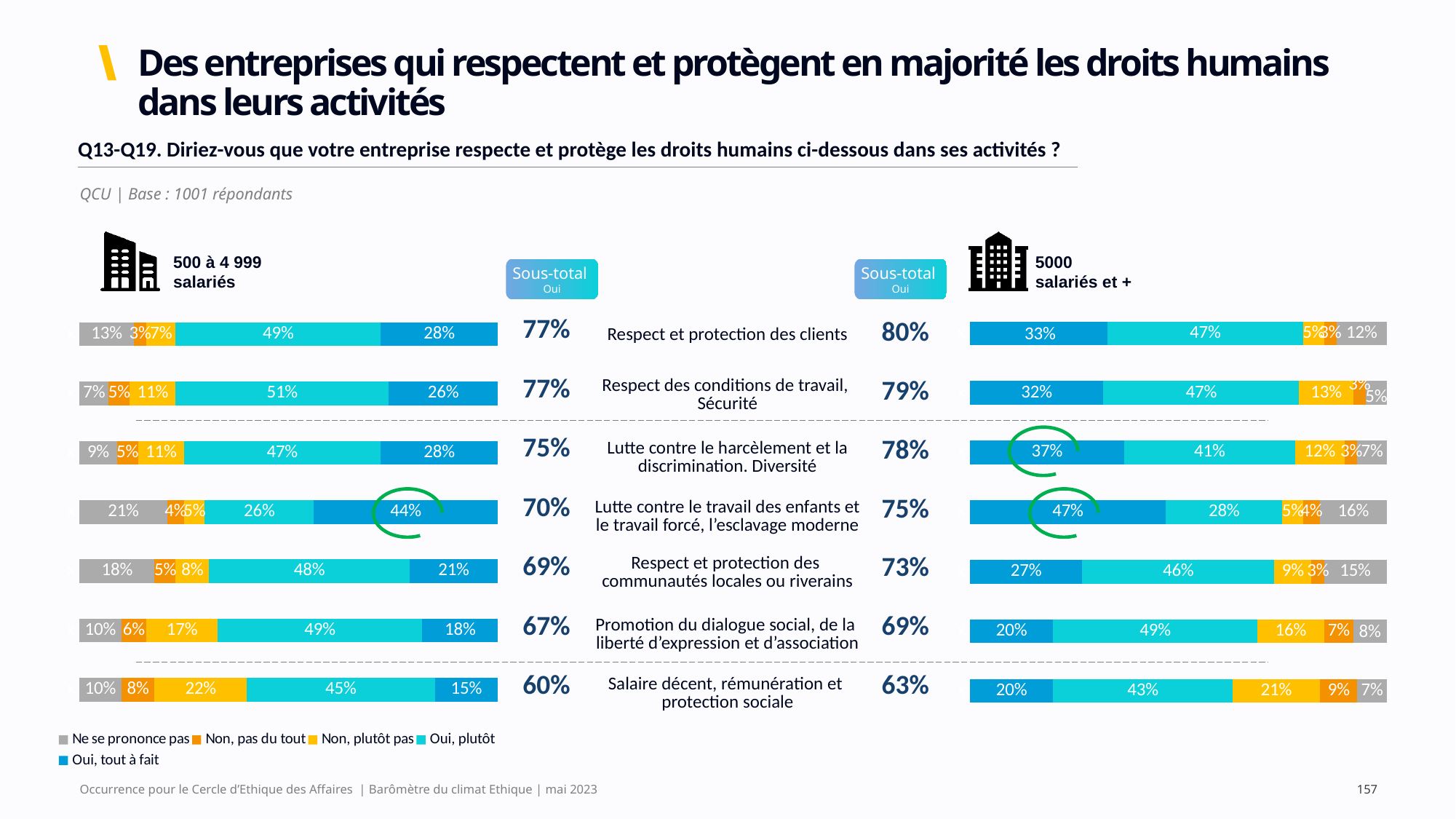
What is the 'Sous-total Oui' for 'Salaire décent, rémunération et protection sociale' in the right chart (5000 salariés et +)? 63% In the left chart (500 à 4 999 salariés), which is larger for 'Respect des conditions de travail, Sécurité': 'Oui, plutôt' or 'Oui, tout à fait'? Oui, plutôt What kind of chart is used on this slide? Stacked bar chart How many items (rows) are shown in each chart? 7 What is the difference between the 'Sous-total Oui' for 'Respect et protection des clients' in the right chart (5000 salariés et +) and in the left chart (500 à 4 999 salariés)? 3 points In the left chart (500 à 4 999 salariés), which item has the lowest 'Oui, tout à fait' value? Salaire décent, rémunération et protection sociale In the right chart (5000 salariés et +), what is the 'Ne se prononce pas' value for 'Respect et protection des communautés locales ou riverains'? 15% In the left chart (500 à 4 999 salariés), what is the 'Oui, tout à fait' value for 'Lutte contre le travail des enfants et le travail forcé, l'esclavage moderne'? 44% How many series does the legend list? 5 In the right chart (5000 salariés et +), what is the 'Oui, plutôt' value for 'Promotion du dialogue social, de la liberté d'expression et d'association'? 49% In the right chart (5000 salariés et +), which item has the highest 'Oui, tout à fait' value? Lutte contre le travail des enfants et le travail forcé, l'esclavage moderne In the left chart (500 à 4 999 salariés), what is the 'Non, plutôt pas' value for 'Salaire décent, rémunération et protection sociale'? 22%